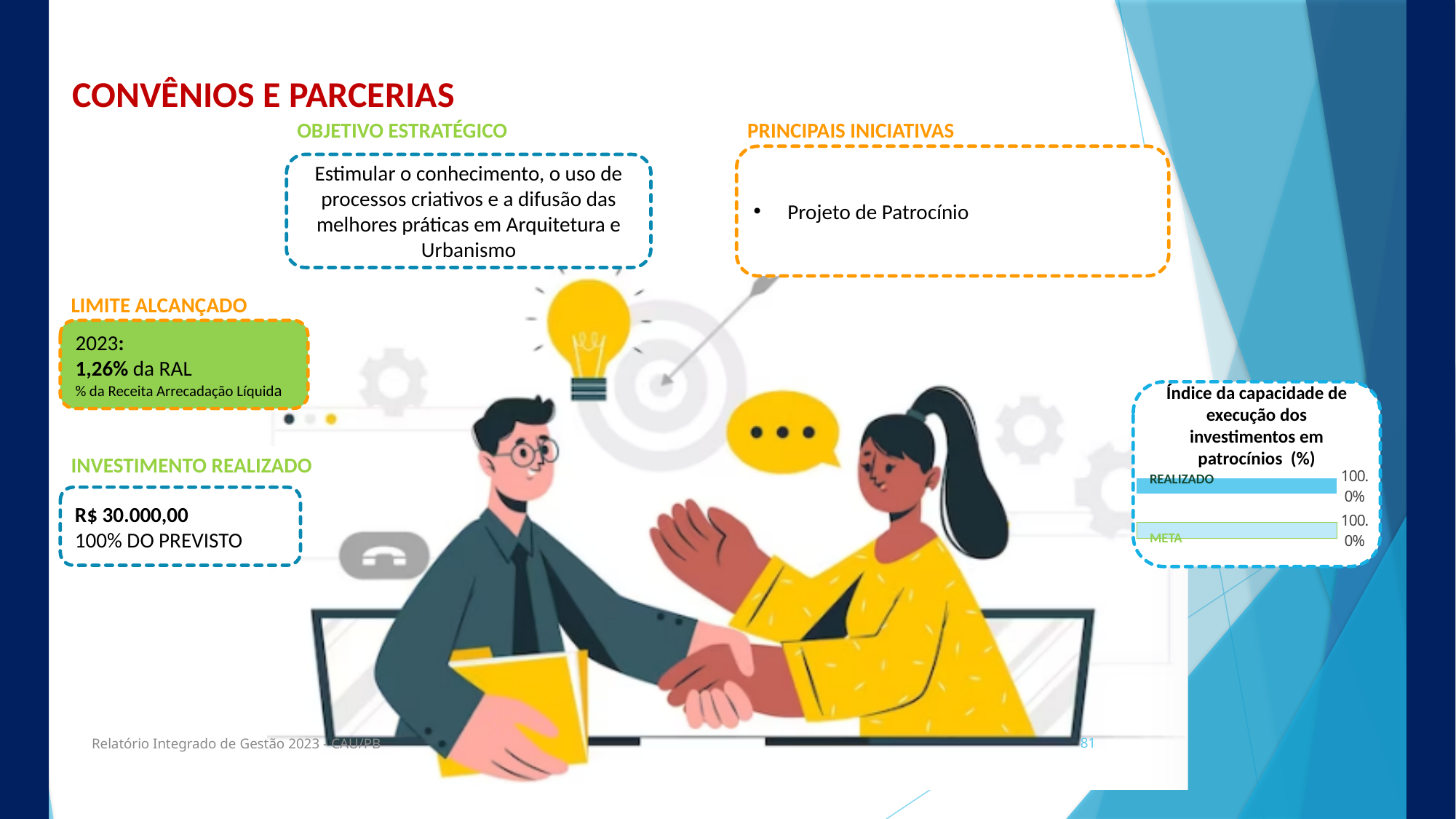
What kind of chart is 'Índice da capacidade de execução dos investimentos em patrocínios (%)'? bar chart What is the difference between the REALIZADO and META values in the chart 'Índice da capacidade de execução dos investimentos em patrocínios (%)'? 0.0% What is the value of the REALIZADO bar in the chart 'Índice da capacidade de execução dos investimentos em patrocínios (%)'? 100.0% What is the title of the chart on the right side of the slide? Índice da capacidade de execução dos investimentos em patrocínios (%) In the chart 'Índice da capacidade de execução dos investimentos em patrocínios (%)', which bar is shown on top, REALIZADO or META? REALIZADO How many bars are plotted in the chart 'Índice da capacidade de execução dos investimentos em patrocínios (%)'? 2 What is the value of the META bar in the chart 'Índice da capacidade de execução dos investimentos em patrocínios (%)'? 100.0%